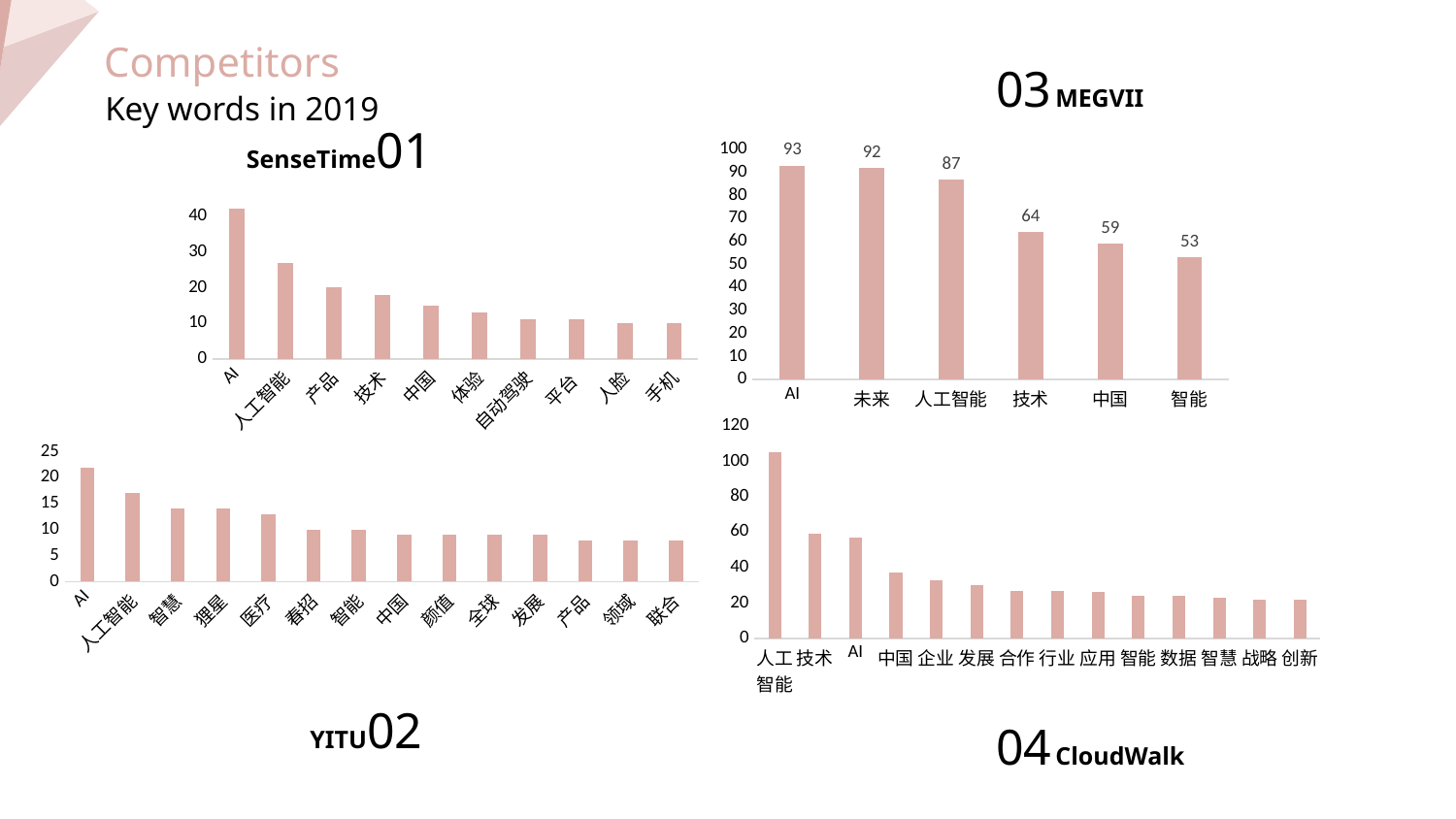
In the CloudWalk chart, is the value for 人工智能 greater or less than 100? greater In the YITU chart, is the value for AI greater or less than 20? greater In the MEGVII chart, what is the value for 技术? 64 What type of chart is the CloudWalk chart? Bar chart In the SenseTime chart, which keyword has the highest value? AI In the MEGVII chart, which keyword has the highest value? AI In the MEGVII chart, what is the value for 未来? 92 In the MEGVII chart, which keyword has the lowest value? 智能 In the MEGVII chart, what is the difference between the values for AI and 中国? 34 In the MEGVII chart, how many keywords are plotted? 6 In the SenseTime chart, is the value for AI greater or less than 40? greater In the SenseTime chart, how many keywords are plotted? 10